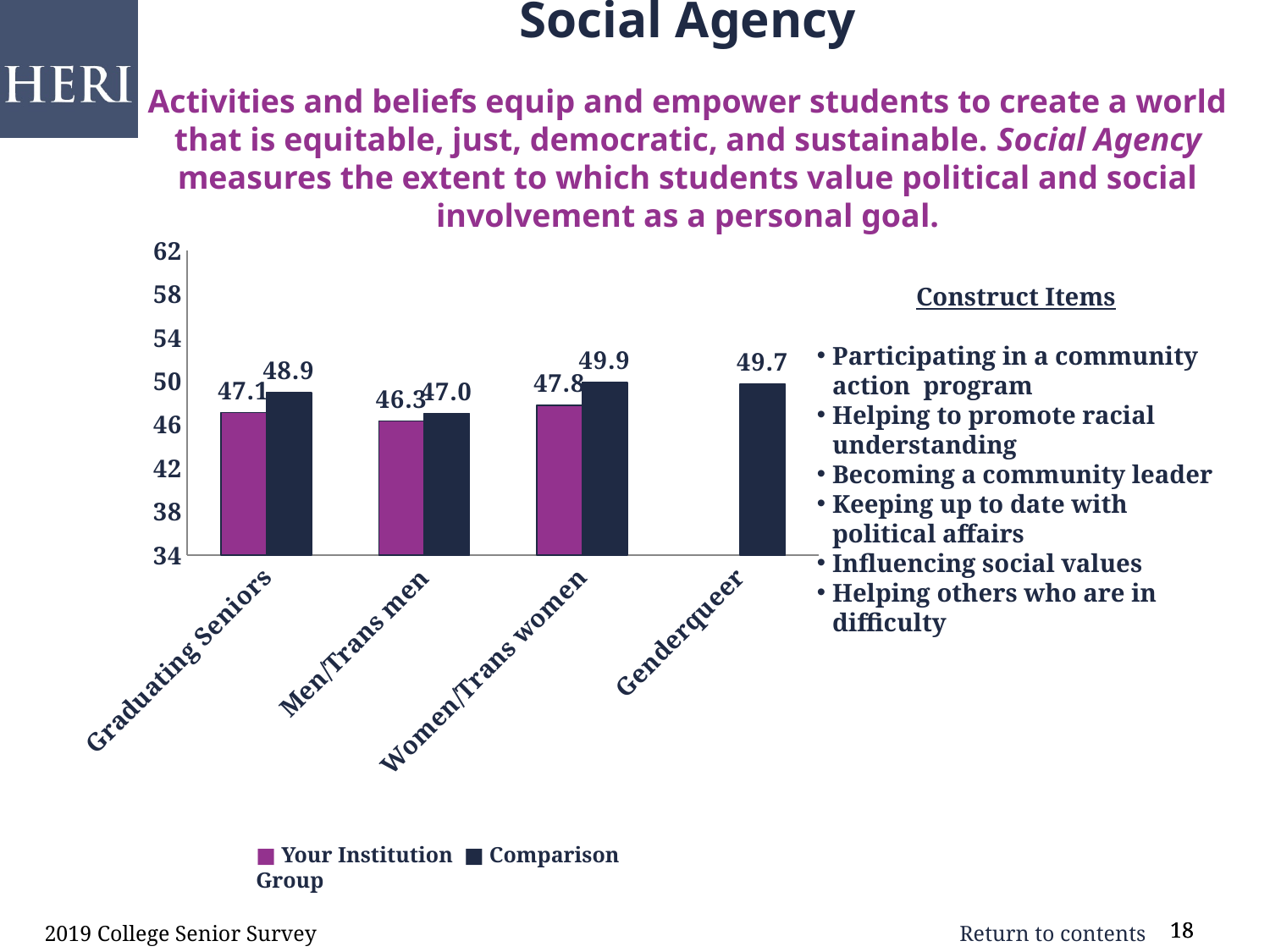
What is the Comparison Group value for Women/Trans women? 49.9 How many categories are shown on the x axis? 4 How many series does the legend list? 2 Which category has the highest Comparison Group value? Women/Trans women What is the difference between the Comparison Group and Your Institution values for Women/Trans women? 2.1 What is the Your Institution value for Men/Trans men? 46.3 What kind of chart is shown on the slide? Bar chart What is the difference between the Comparison Group and Your Institution values for Graduating Seniors? 1.8 Which is larger for Men/Trans men: the Your Institution value or the Comparison Group value? Comparison Group What is the Your Institution value for Graduating Seniors? 47.1 Which category has the lowest Your Institution value? Men/Trans men What is the Comparison Group value for Genderqueer? 49.7